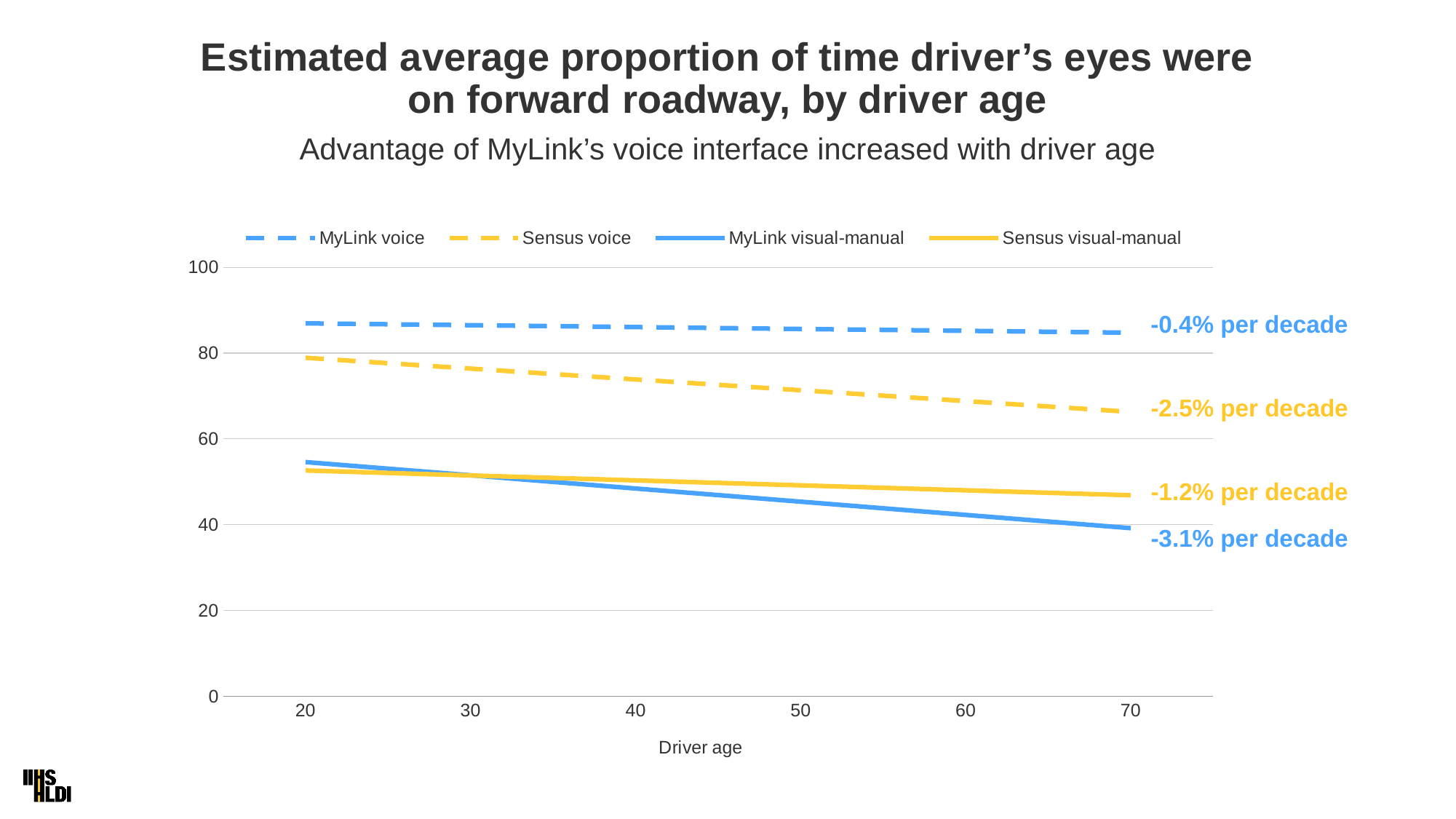
Which series has the highest value at driver age 70? MyLink voice What rate of change per decade is annotated for the Sensus visual-manual line? -1.2% per decade What rate of change per decade is annotated for the MyLink visual-manual line? -3.1% per decade Is the value for MyLink voice at driver age 20 greater or less than 80? greater How many series does the legend list? 4 Which series has the lowest value at driver age 70? MyLink visual-manual What rate of change per decade is annotated for the Sensus voice line? -2.5% per decade Is the value for Sensus voice at driver age 70 greater or less than 80? less What rate of change per decade is annotated for the MyLink voice line? -0.4% per decade What kind of chart is shown on the slide? line chart Do the values for Sensus voice rise or fall as driver age increases? fall What is the label of the x axis? Driver age